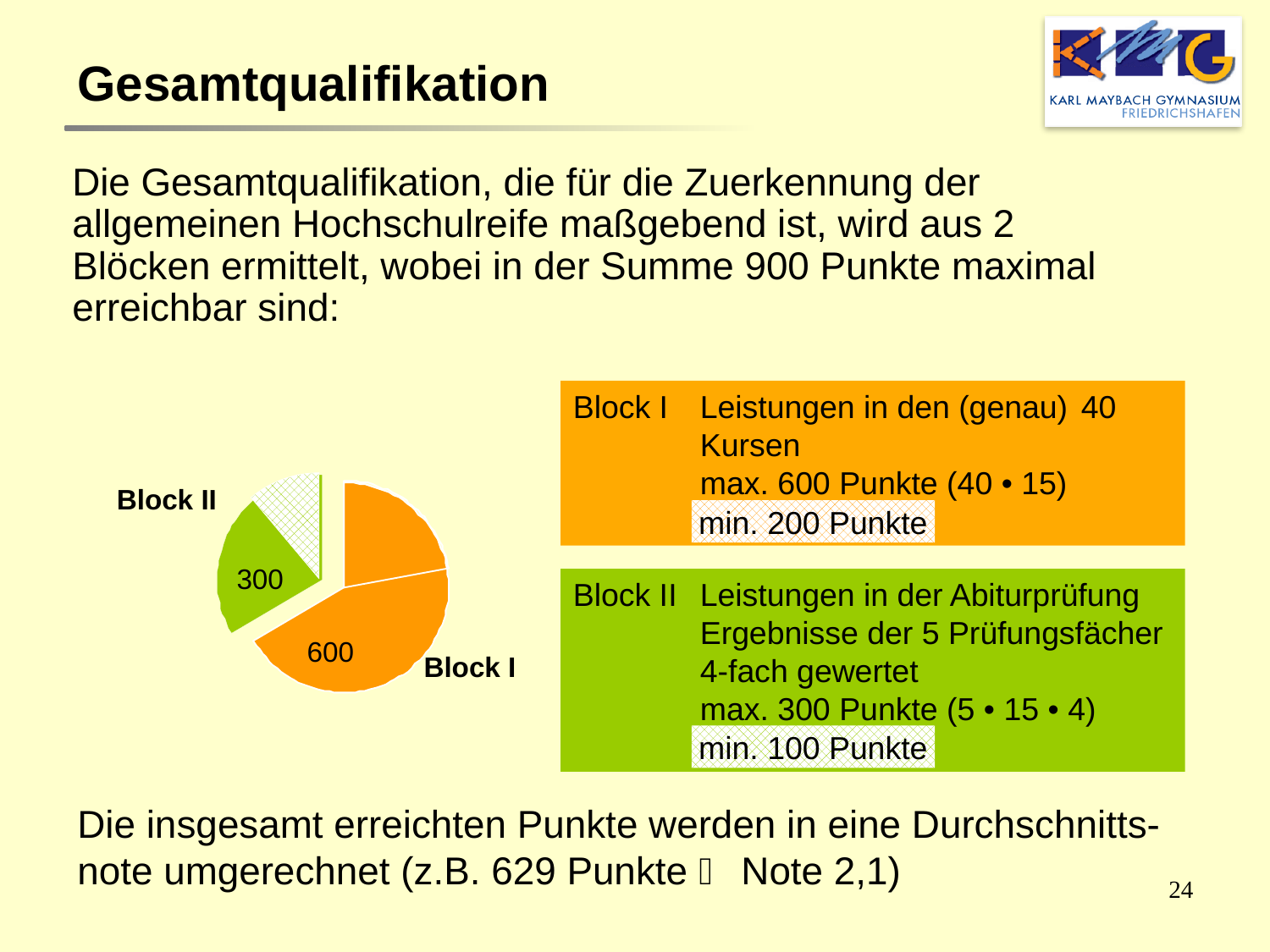
What value is shown for Block I in the pie chart? 600 What is the difference between the values for Block I and Block II in the pie chart? 300 What kind of chart is shown on the slide? pie chart How many blocks are labelled in the pie chart? 2 What value is shown for Block II in the pie chart? 300 What colour is the Block II slice in the pie chart? green Which block has the larger slice in the pie chart? Block I What colour is the Block I slice in the pie chart? orange What fraction of the pie does Block II represent? one third Which block has the smaller slice in the pie chart? Block II Is the value for Block I larger or smaller than the value for Block II? larger What is the total of the two values labelled in the pie chart? 900